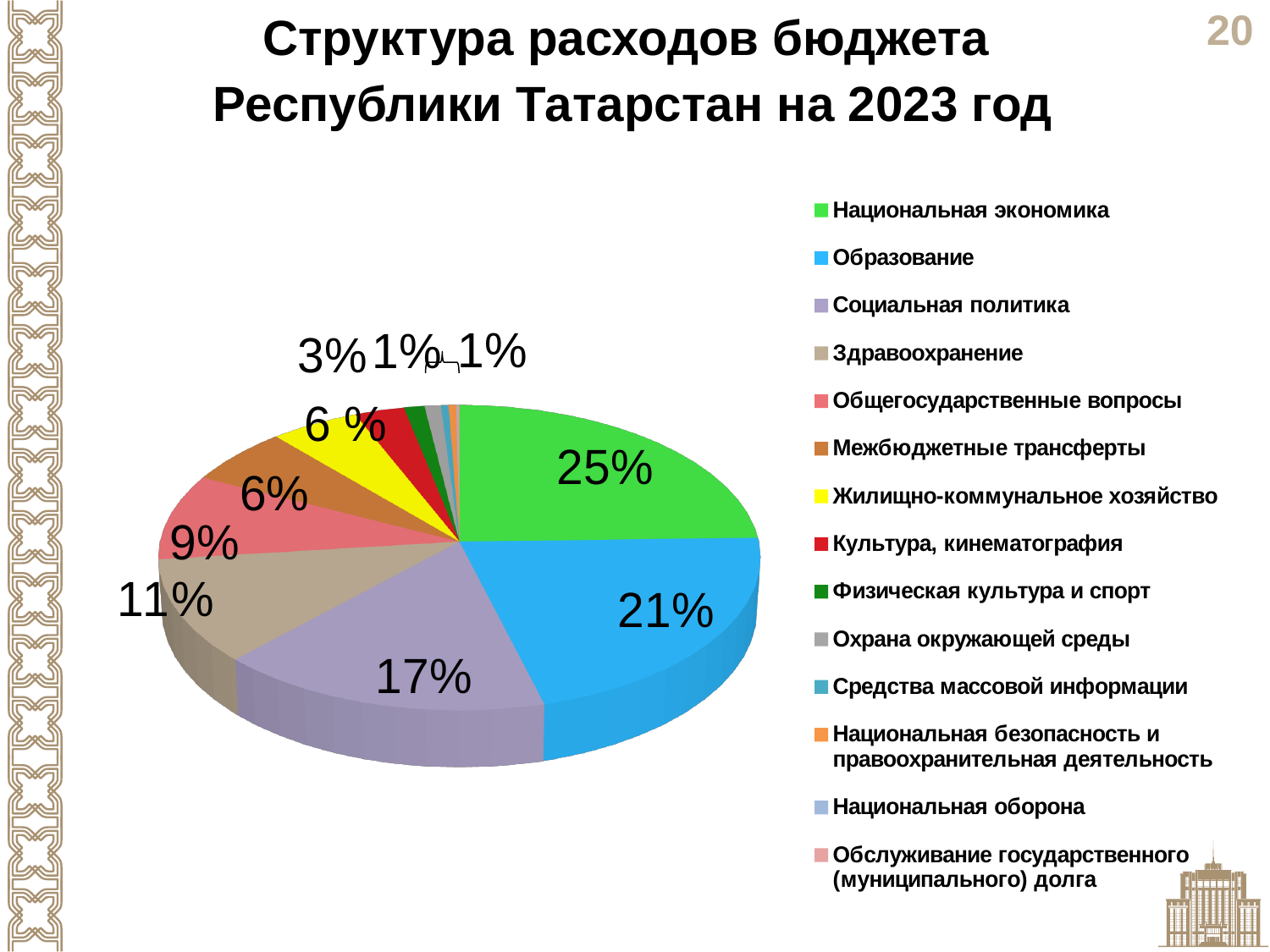
What share of the budget expenditure goes to Здравоохранение? 11% What share of the budget expenditure goes to Социальная политика? 17% What share of the budget expenditure goes to Образование? 21% What kind of chart is shown on the slide? Pie chart What share of the budget expenditure goes to Общегосударственные вопросы? 9% How many percentage points larger is the share of Национальная экономика than the share of Образование? 4 What share of the budget expenditure goes to Жилищно-коммунальное хозяйство? 6% What share of the budget expenditure goes to Национальная экономика? 25% Which has a larger share: Образование or Социальная политика? Образование What is the title of the chart on the slide? Структура расходов бюджета Республики Татарстан на 2023 год How many categories does the legend list? 14 Which category has the largest share of the budget expenditure? Национальная экономика